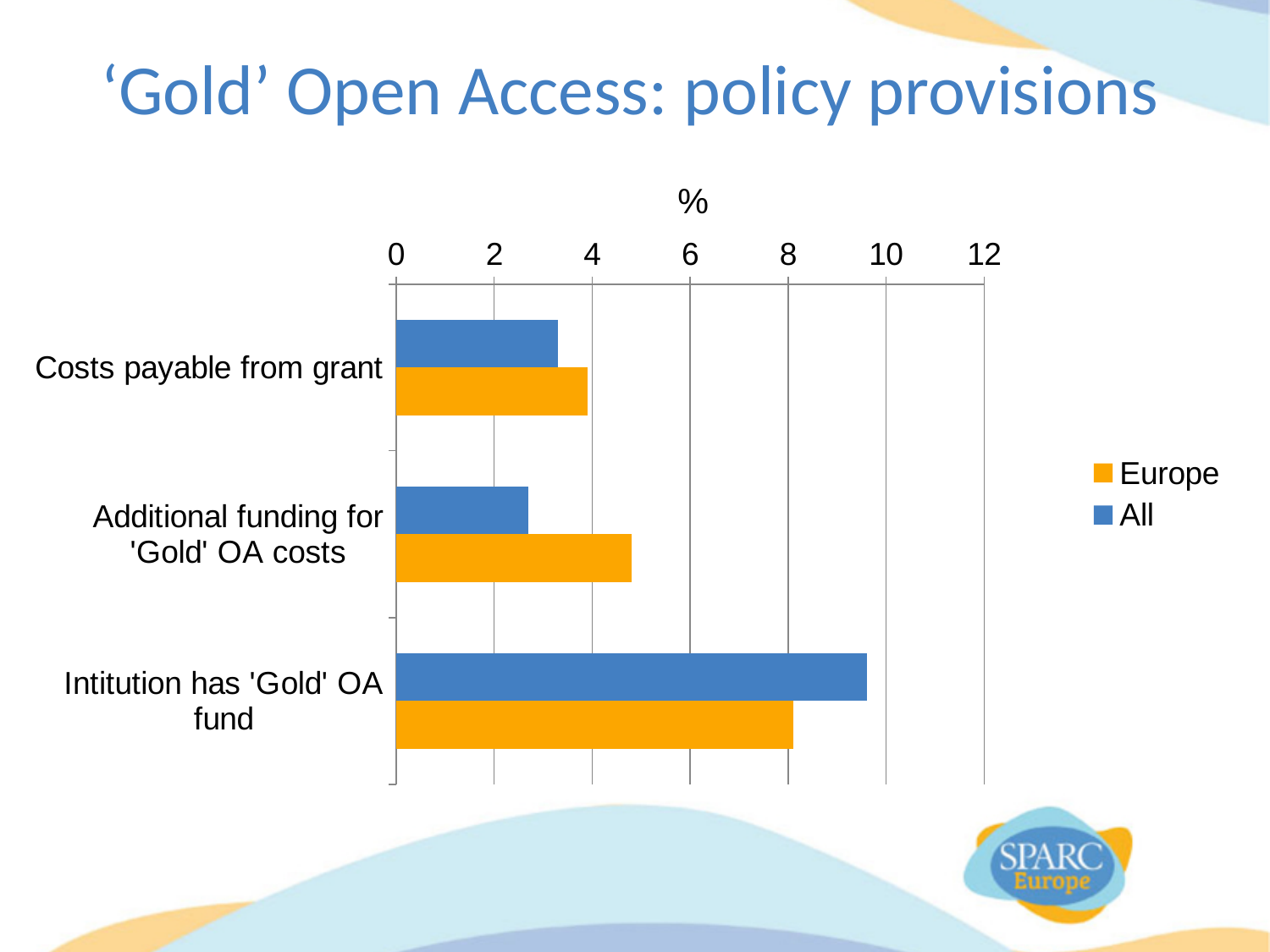
How many series does the legend list? 2 Which category has the highest value for the All series? Intitution has 'Gold' OA fund For 'Additional funding for 'Gold' OA costs', which is larger, the Europe value or the All value? Europe Which category has the lowest value for the All series? Additional funding for 'Gold' OA costs Is the Europe value for 'Additional funding for 'Gold' OA costs' greater or less than 4? greater Is the All value for 'Costs payable from grant' greater or less than 4? less What kind of chart is shown on the slide? Bar chart How many categories are shown on the chart? 3 Which category has the lowest value for the Europe series? Costs payable from grant What colour represents the Europe series in the chart? Orange For 'Intitution has 'Gold' OA fund', which is larger, the Europe value or the All value? All Is the All value for 'Intitution has 'Gold' OA fund' greater or less than 8? greater